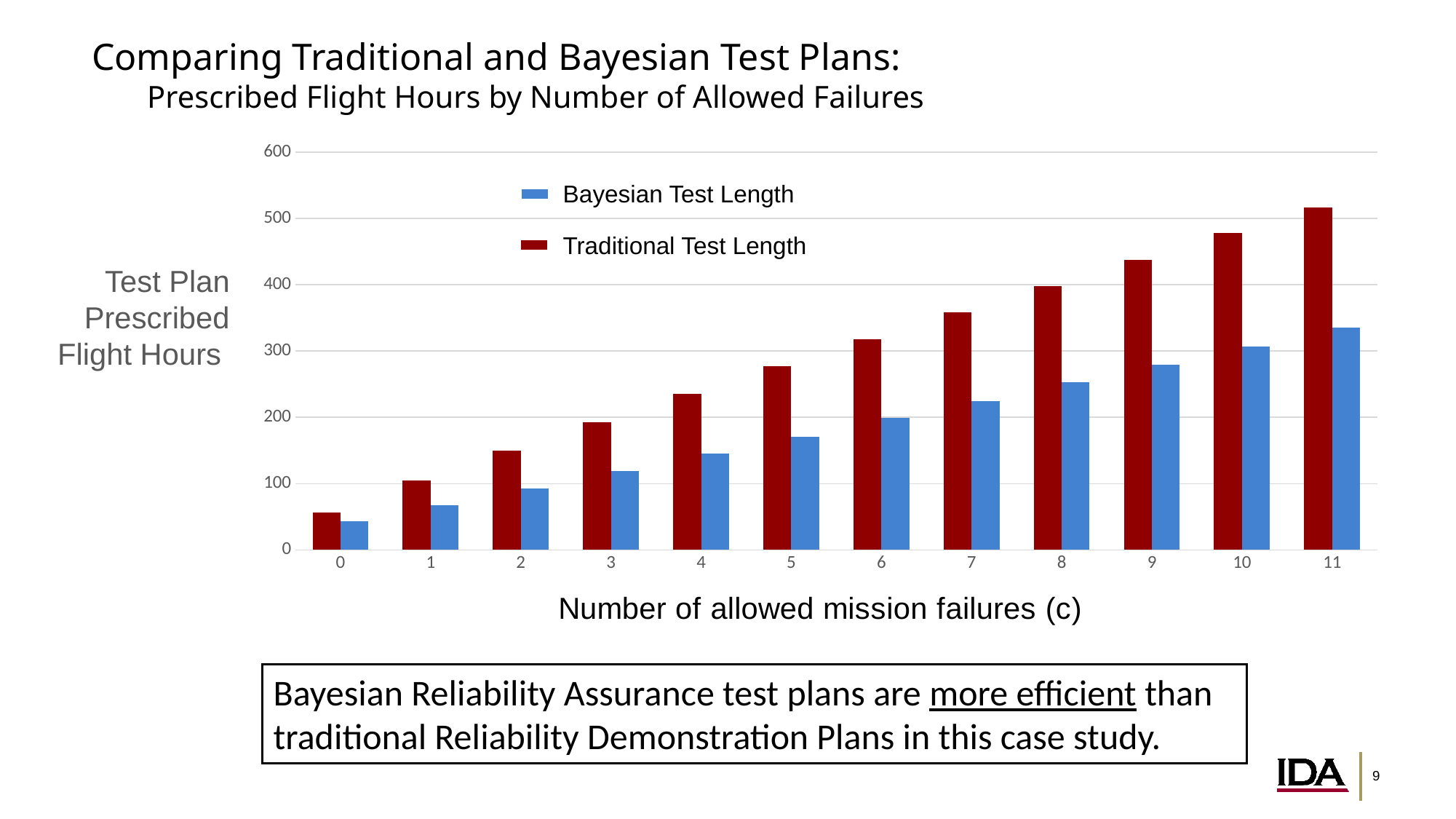
Which series is shown in dark red? Traditional Test Length Is the Traditional Test Length value at 0 allowed failures greater or less than 100? less How many categories (numbers of allowed mission failures) are shown on the x axis? 12 Is the Traditional Test Length value at 11 allowed failures greater or less than 500? greater How many series does the legend list? 2 Is the Bayesian Test Length value at 8 allowed failures greater or less than 200? greater What kind of chart is shown on the slide? bar chart What is the x-axis label of the chart? Number of allowed mission failures (c) At 6 allowed failures, which is larger: the Traditional Test Length or the Bayesian Test Length? Traditional Test Length At which number of allowed failures is the Traditional Test Length highest? 11 At which number of allowed failures is the Bayesian Test Length lowest? 0